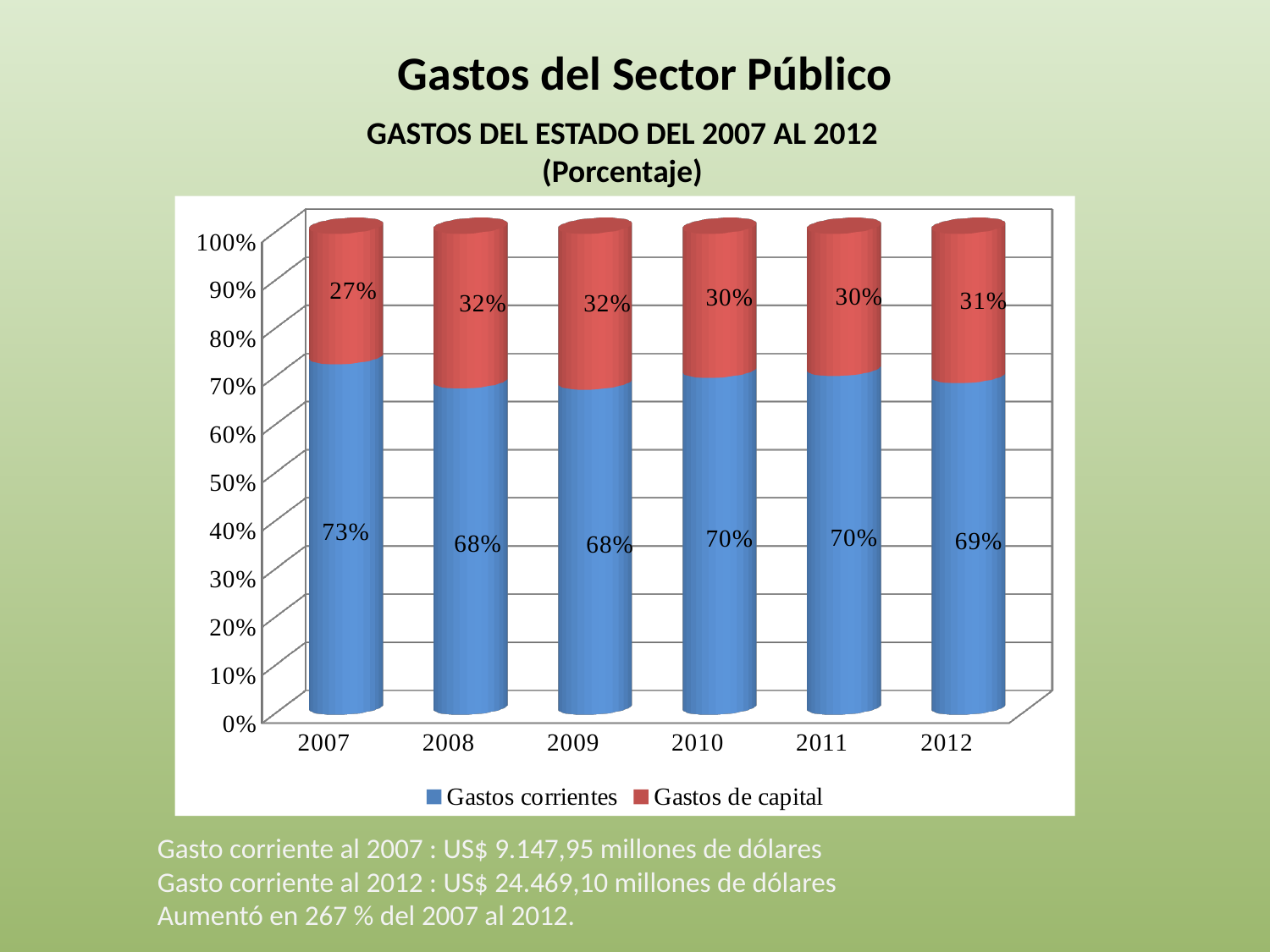
Which colour represents Gastos de capital in the legend? Red What is the value for Gastos corrientes in 2007? 73% What is the total of the stacked bar for 2011? 100% What is the value for Gastos de capital in 2009? 32% In which year is Gastos de capital lowest? 2007 How many series does the legend list? 2 Which is larger in 2008: Gastos corrientes or Gastos de capital? Gastos corrientes What is the difference between Gastos corrientes and Gastos de capital in 2010? 40% How many years are shown on the x axis? 6 What is the value for Gastos de capital in 2012? 31% In which year is Gastos corrientes highest? 2007 What kind of chart is this? Stacked bar chart